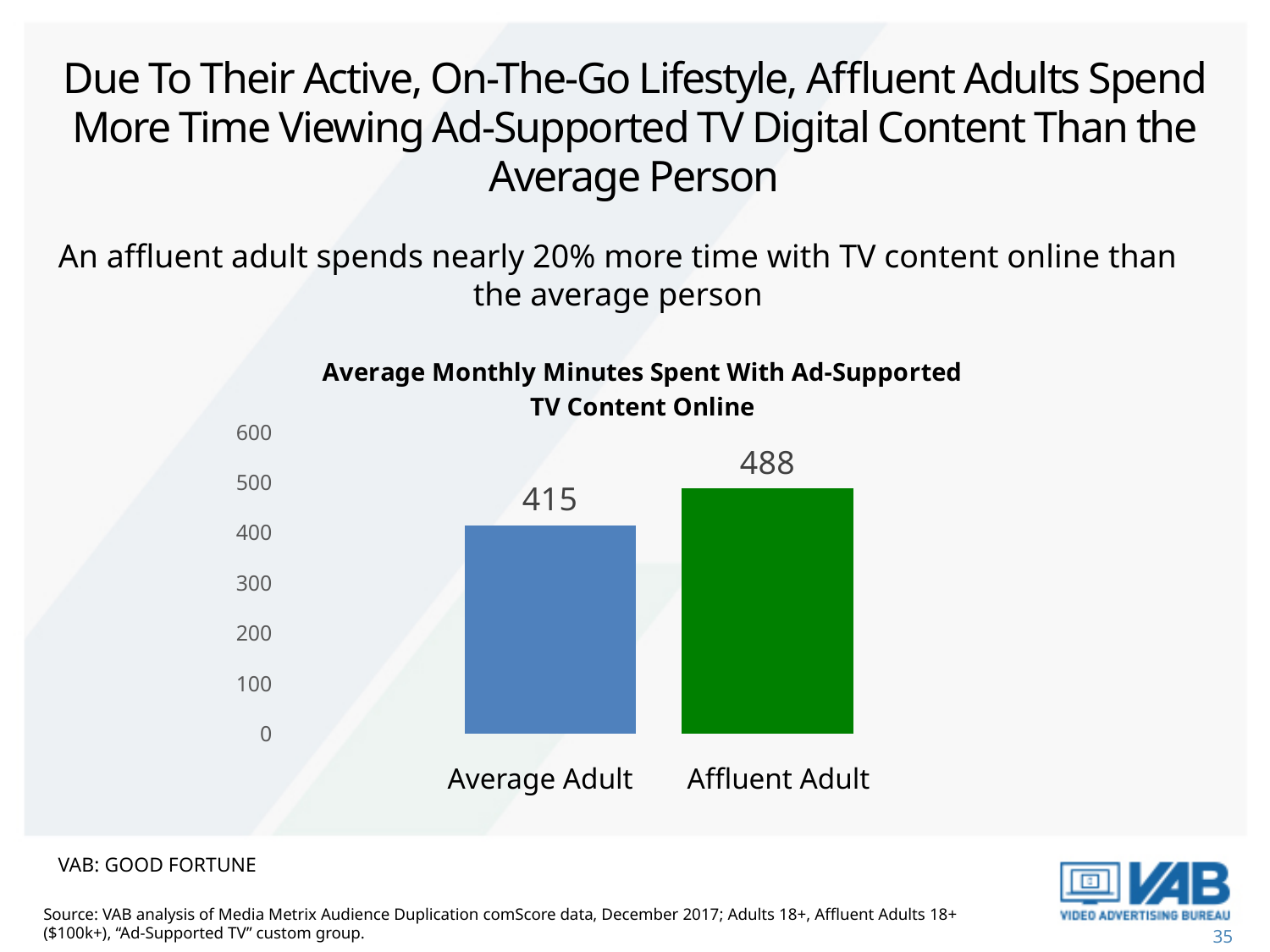
Which category has the highest value? Affluent Adult What is the difference between the values for Affluent Adult and Average Adult? 73 Is the value for Affluent Adult greater or less than 400? greater What is the value for Average Adult? 415 What colour is the bar for Affluent Adult? green What kind of chart is shown on the slide? bar chart Is the value for Average Adult greater or less than 500? less Which category has the lowest value? Average Adult What is the title of the chart? Average Monthly Minutes Spent With Ad-Supported TV Content Online What is the value for Affluent Adult? 488 Which is larger, the value for Average Adult or the value for Affluent Adult? Affluent Adult How many categories are shown in the chart? 2